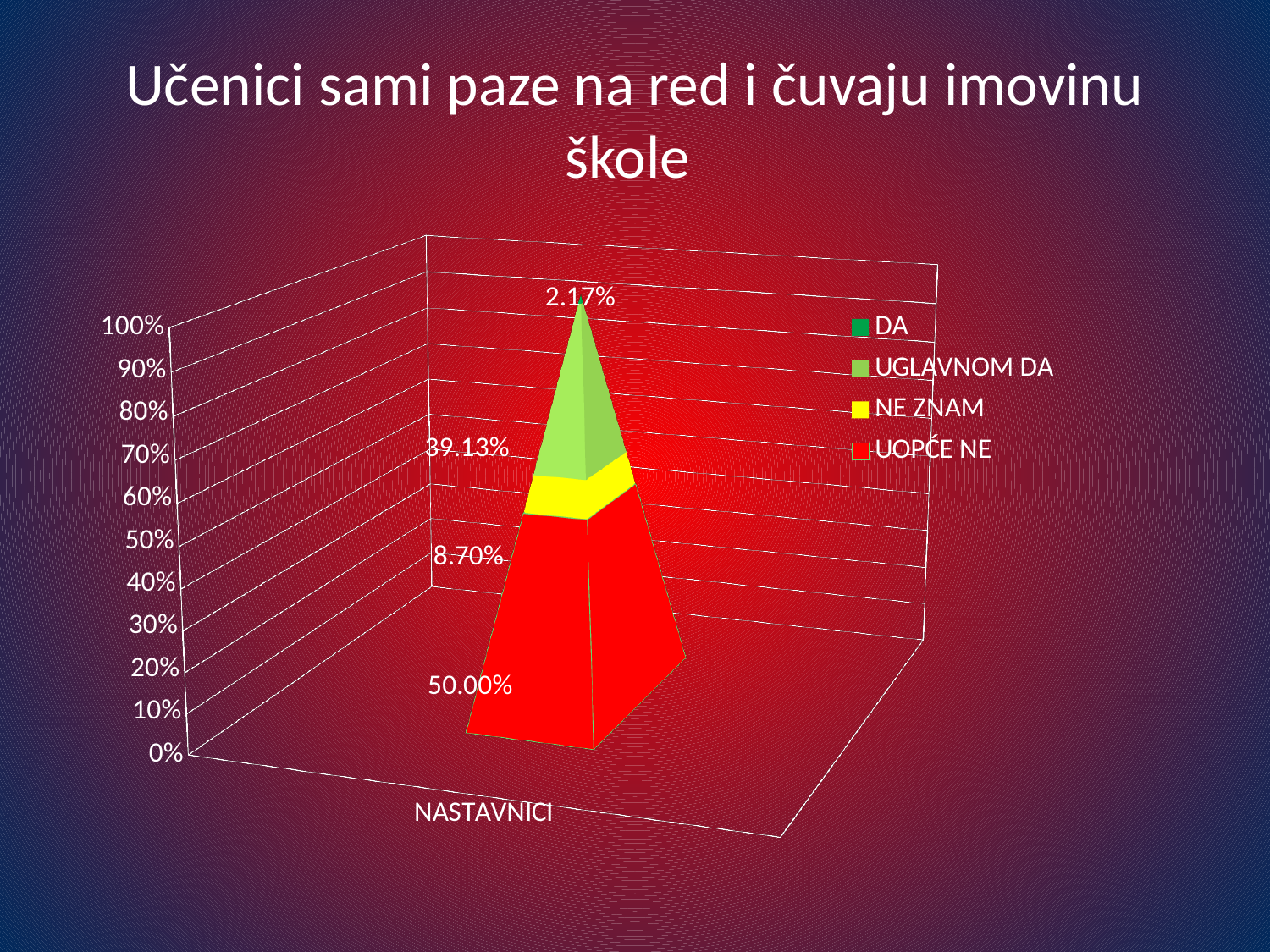
What is the difference between the UOPĆE NE value and the UGLAVNOM DA value? 10.87% What is the value for UGLAVNOM DA for NASTAVNICI? 39.13% What is the value for UOPĆE NE for NASTAVNICI? 50.00% Which series has the lowest value for NASTAVNICI? DA What is the value for NE ZNAM for NASTAVNICI? 8.70% What is the title of the chart? Učenici sami paze na red i čuvaju imovinu škole Which is larger, the value for NE ZNAM or the value for DA? NE ZNAM What is the value for DA for NASTAVNICI? 2.17% How many series does the legend list? 4 Which series has the highest value for NASTAVNICI? UOPĆE NE How many categories are shown on the x axis? 1 What is the total of the stacked bar for NASTAVNICI? 100.00%